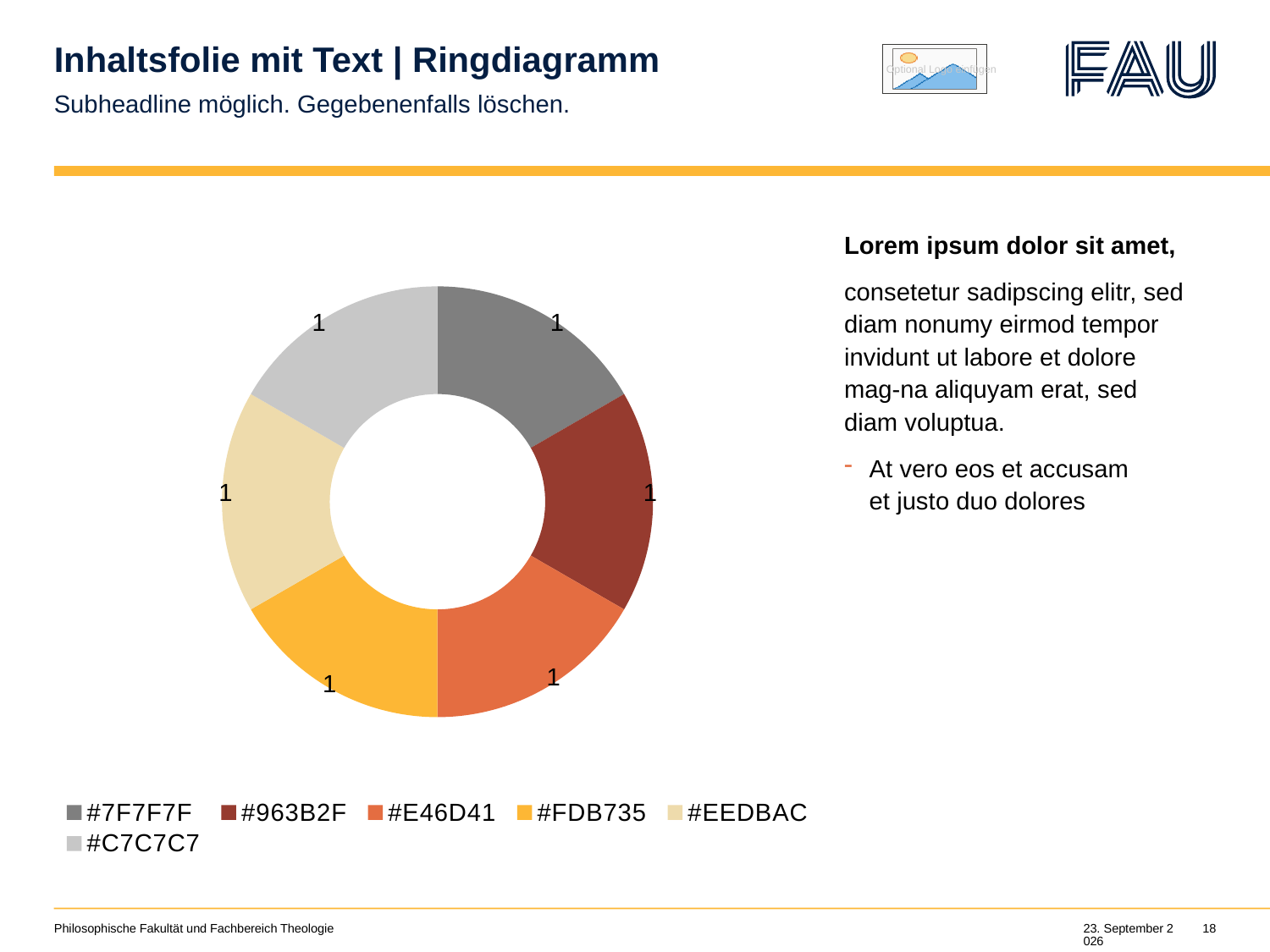
How many slices does the doughnut chart have? 6 What is the value of the #EEDBAC slice in the doughnut chart? 1 What is the value of the #963B2F slice in the doughnut chart? 1 How many entries does the chart legend list? 6 Is the value of the #FDB735 slice larger than, smaller than, or equal to the value of the #7F7F7F slice? equal What is the total of all slice values in the doughnut chart? 6 What is the value of the #C7C7C7 slice in the doughnut chart? 1 What is the value of the #E46D41 slice in the doughnut chart? 1 What is the title of the slide containing the doughnut chart? Inhaltsfolie mit Text | Ringdiagramm What is the value of the #7F7F7F slice in the doughnut chart? 1 What kind of chart is shown on the slide? doughnut chart What is the value of the #FDB735 slice in the doughnut chart? 1